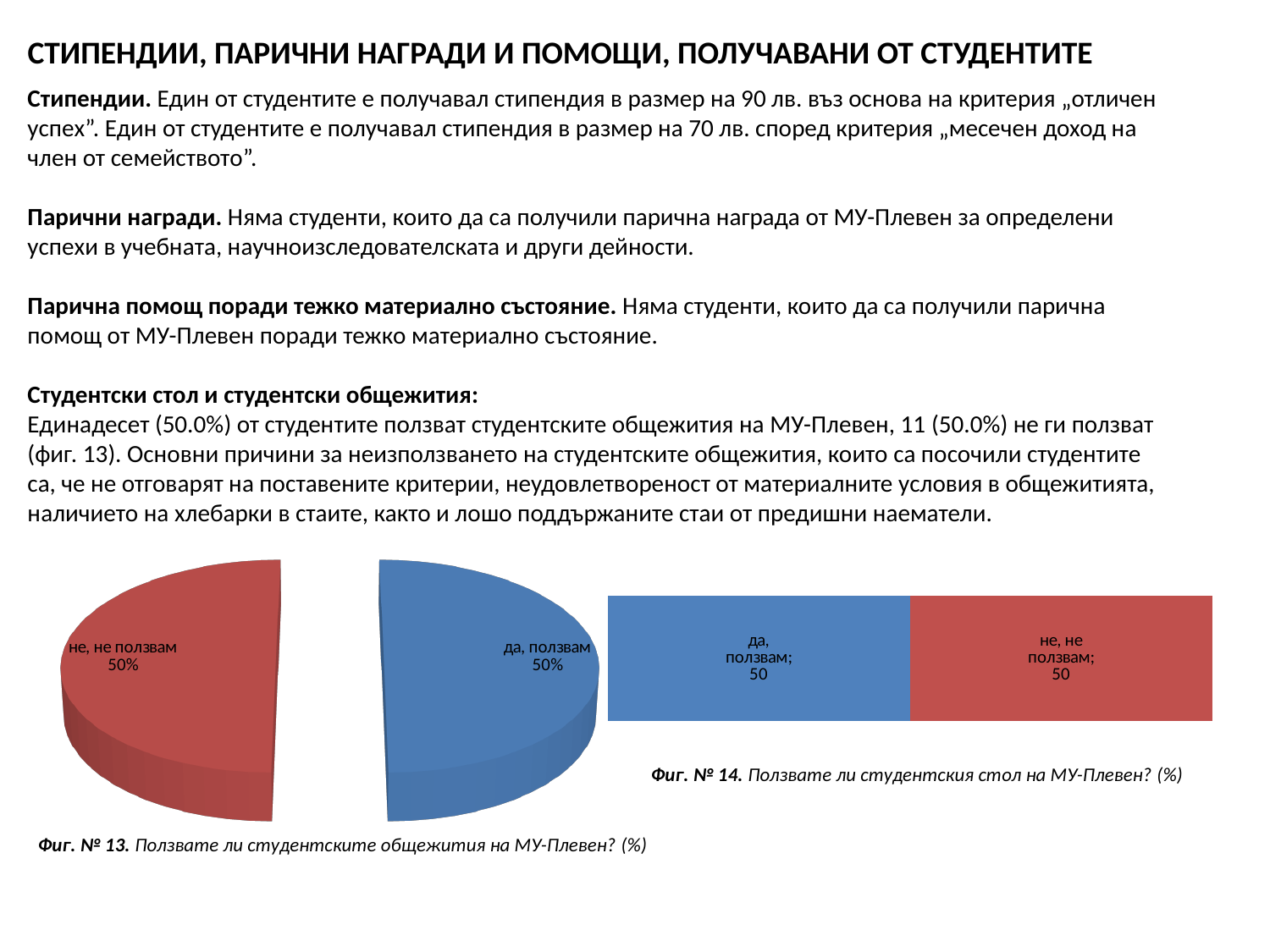
In the chart titled Фиг. № 14, what is the total of the two segments of the stacked bar? 100 What kind of chart is Фиг. № 14? Bar chart In the chart titled Фиг. № 13, what percentage of students answered "не, не ползвам"? 50% In the chart titled Фиг. № 14, what is the value for "да, ползвам"? 50 In the chart titled Фиг. № 13, what percentage of students answered "да, ползвам"? 50% How many slices does the pie chart Фиг. № 13 have? 2 In the chart titled Фиг. № 13, what is the difference between the "да, ползвам" and "не, не ползвам" slices? 0% In the chart titled Фиг. № 13, what colour is the "да, ползвам" slice? Blue In the chart titled Фиг. № 14, what is the value for "не, не ползвам"? 50 How many segments does the stacked bar in Фиг. № 14 contain? 2 In the chart titled Фиг. № 14, what colour is the "не, не ползвам" segment? Red What kind of chart is Фиг. № 13? Pie chart